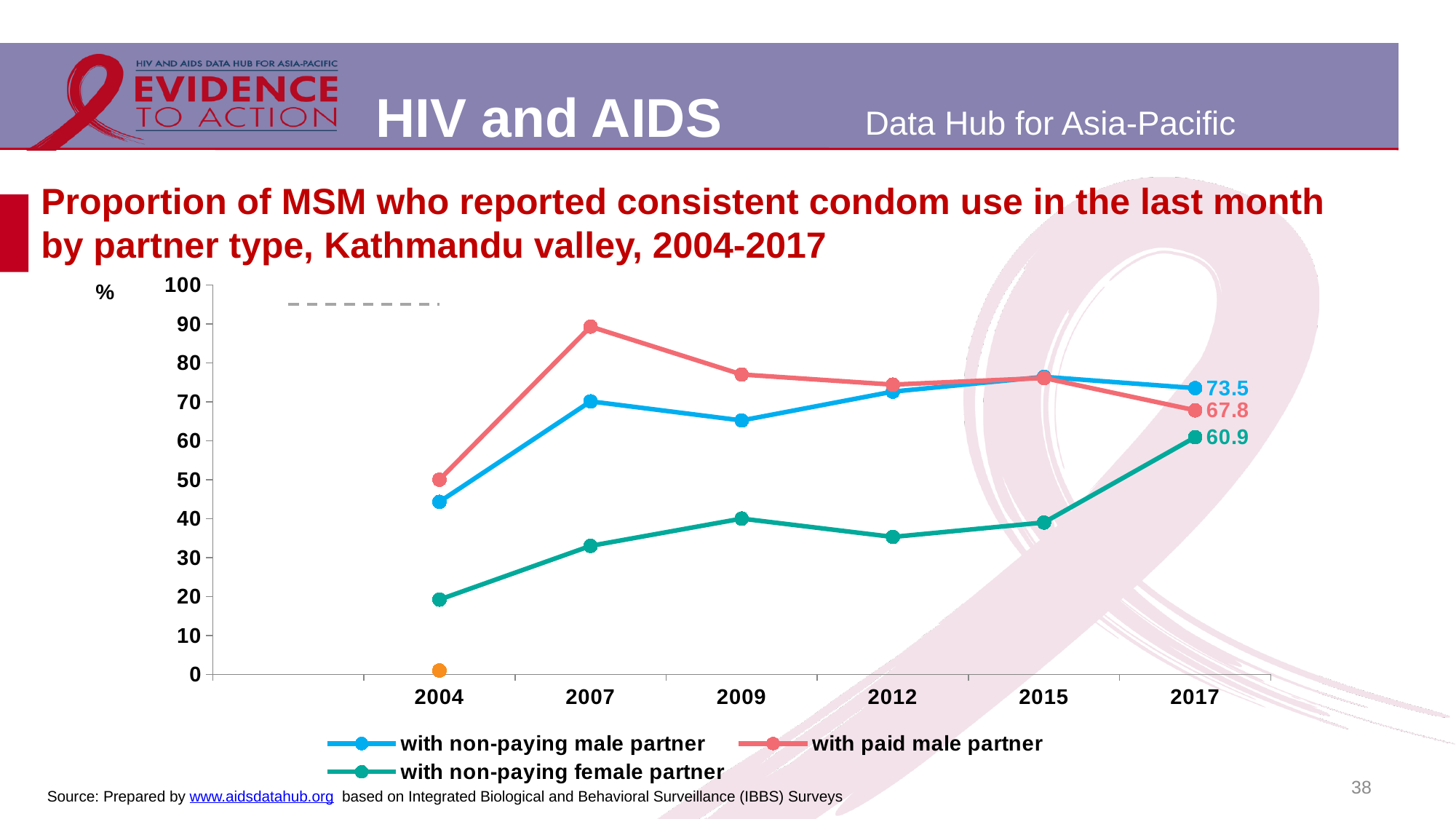
In which year does 'with paid male partner' reach its highest value? 2007 What is the difference between the 2017 values for 'with non-paying male partner' and 'with non-paying female partner'? 12.6 Which series has the highest value in 2017? with non-paying male partner What type of chart is shown on the slide? Line chart Is the value for 'with non-paying female partner' in 2004 greater or less than 30? less Which series has the lowest value in 2017? with non-paying female partner What is the value for 'with non-paying male partner' in 2017? 73.5 How many series does the legend list? 3 How many years are shown on the x axis? 6 What is the value for 'with non-paying female partner' in 2017? 60.9 Is the value for 'with paid male partner' in 2007 greater or less than 80? greater What is the value for 'with paid male partner' in 2017? 67.8